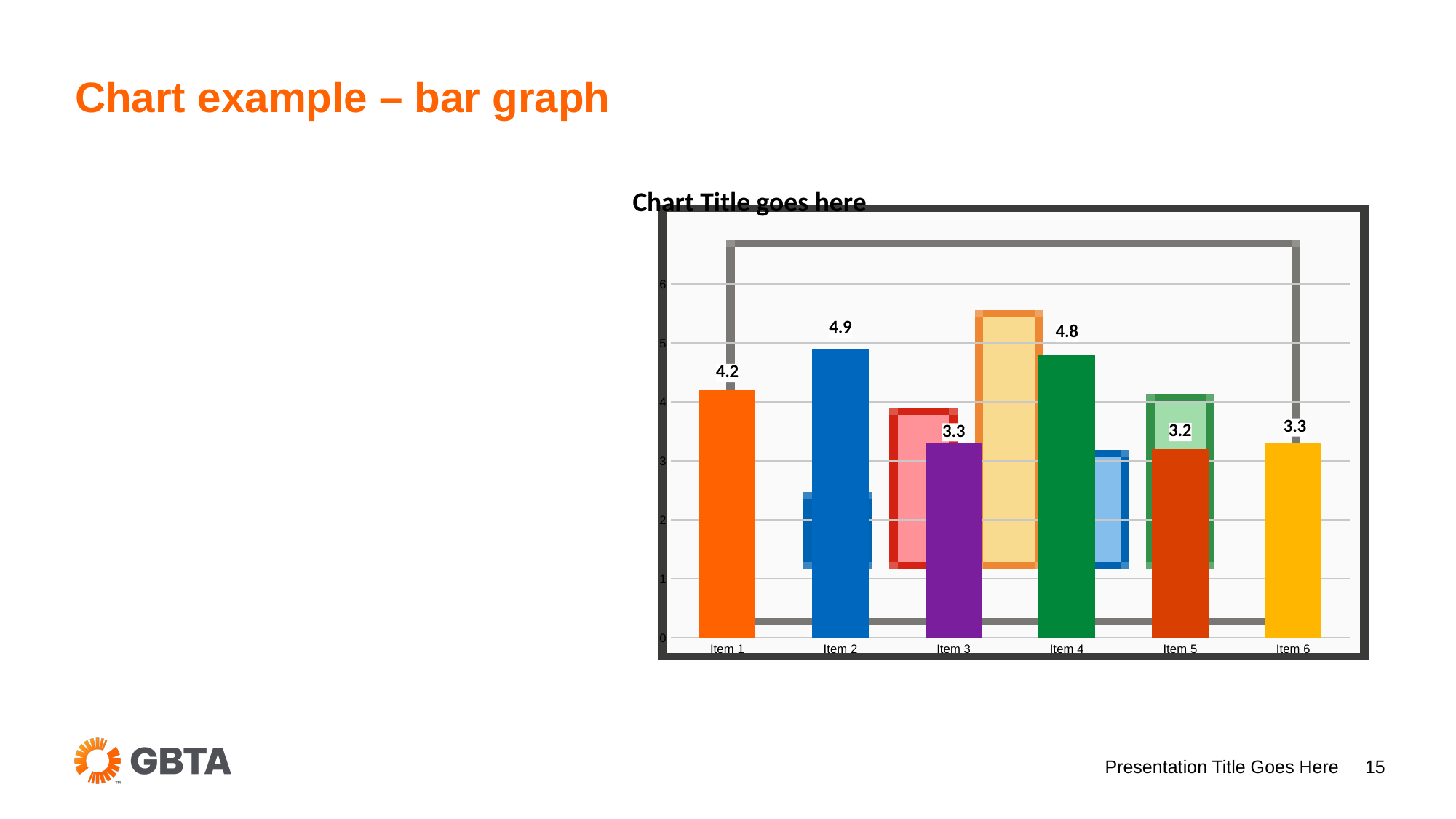
Which is larger, the value for Item 1 or the value for Item 3? Item 1 Which item has the highest value? Item 2 What is the difference between the values for Item 4 and Item 5? 1.6 What is the value for Item 1? 4.2 How many items are shown on the x axis? 6 What is the value for Item 2? 4.9 Is the value for Item 2 greater or less than 4? greater What kind of chart is shown on the slide? bar chart What is the value for Item 4? 4.8 What is the title of the chart? Chart Title goes here What is the value for Item 5? 3.2 What is the difference between the values for Item 2 and Item 1? 0.7